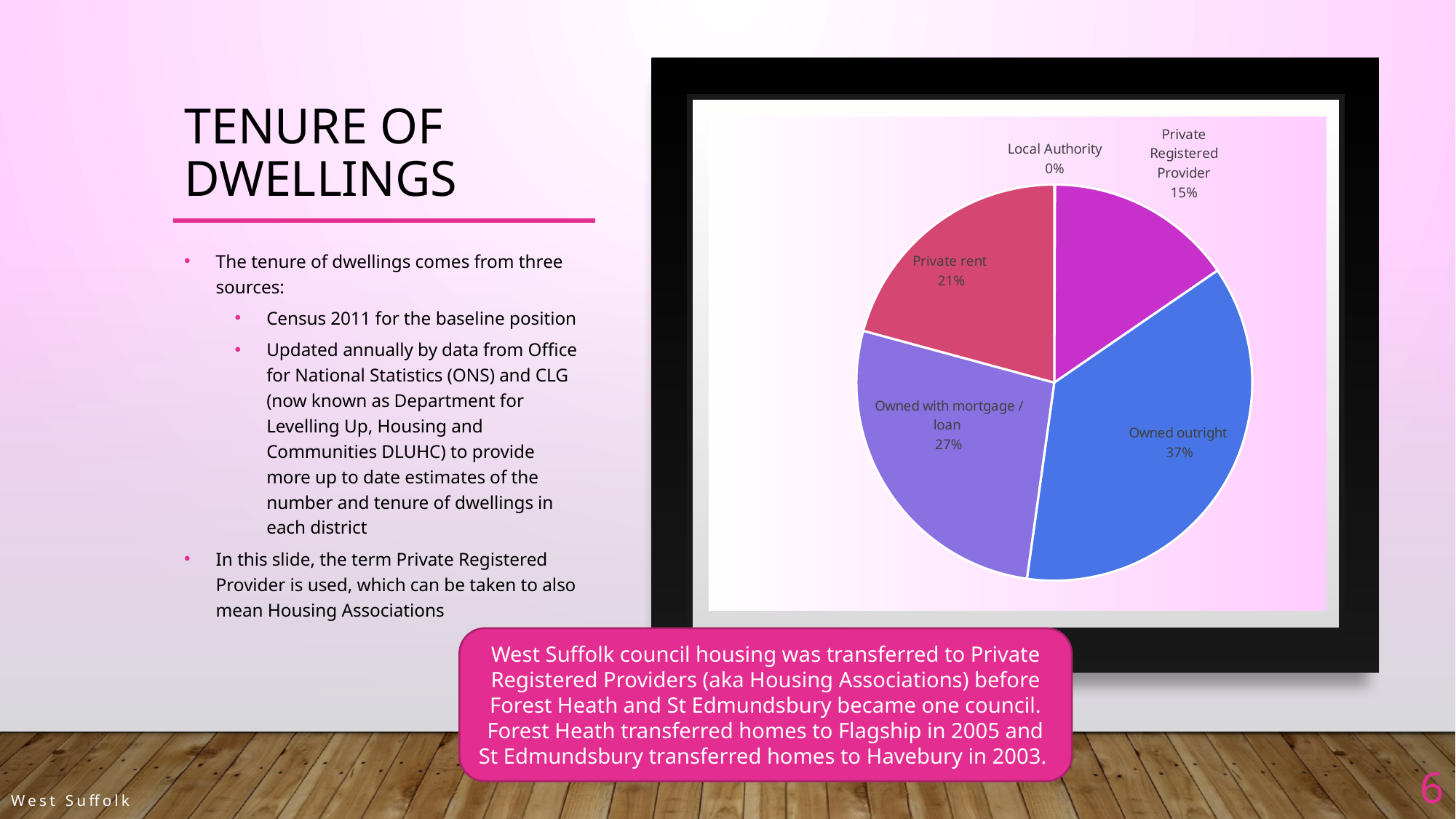
What kind of chart is shown on the slide? Pie chart How many tenure categories are shown in the pie chart? 5 What is the difference in percentage points between Owned outright and Owned with mortgage / loan? 10 What share of dwellings is Local Authority? 0% Which tenure category has the smallest share? Local Authority Which is larger, Private rent or Private Registered Provider? Private rent What share of dwellings is Owned outright? 37% What share of dwellings is Private rent? 21% What is the combined share of Owned outright and Owned with mortgage / loan? 64% Which tenure category has the largest share? Owned outright What share of dwellings is Owned with mortgage / loan? 27% What share of dwellings is Private Registered Provider? 15%